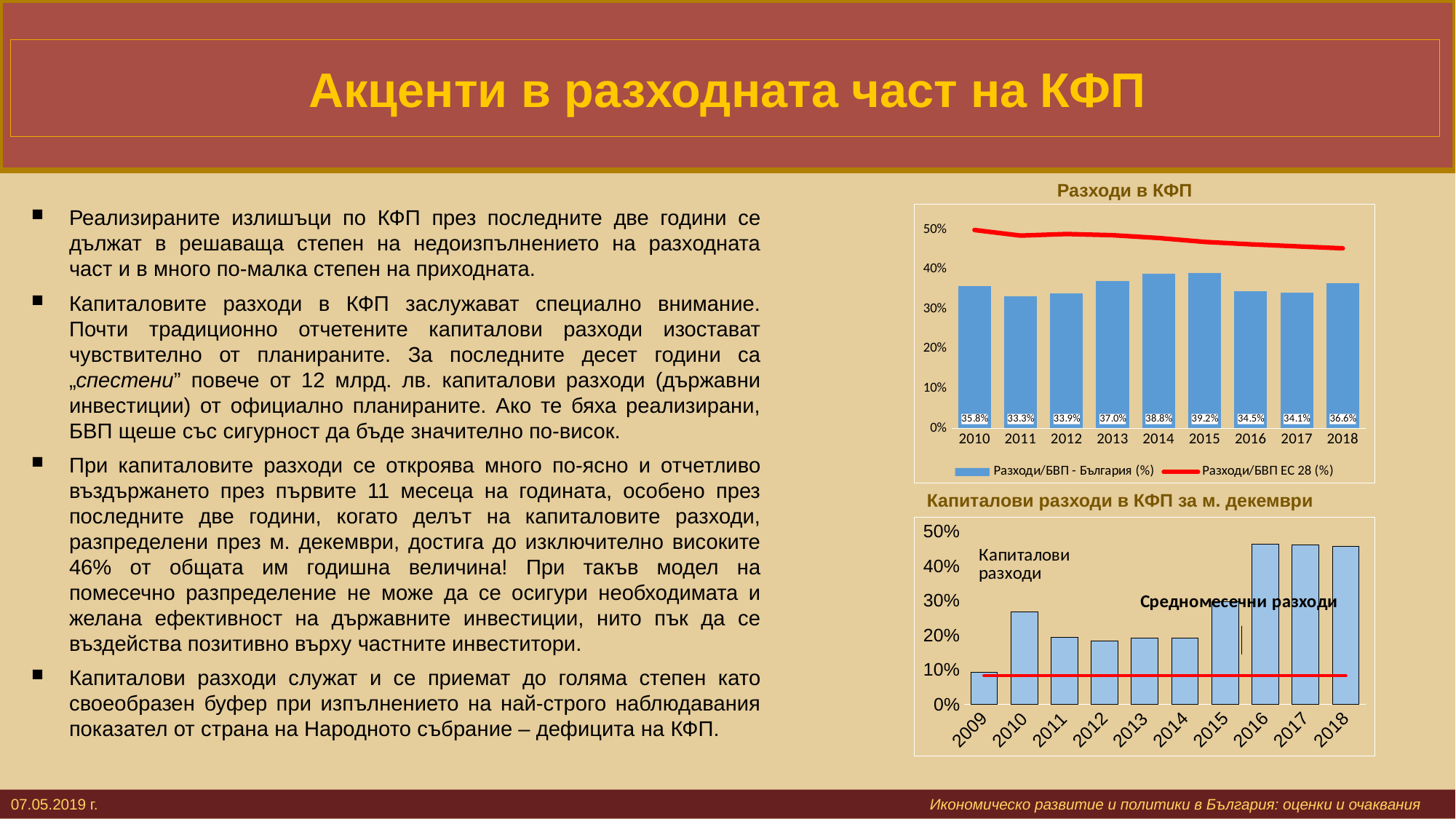
In the chart titled "Капиталови разходи в КФП за м. декември", is the value for 2017 greater or less than 40%? greater In the chart titled "Разходи в КФП", how many series does the legend list? 2 In the chart titled "Разходи в КФП", which year has the highest bar value? 2015 In the chart titled "Разходи в КФП", how many years are shown on the x axis? 9 In the chart titled "Разходи в КФП", which year has the lowest bar value? 2011 In the chart titled "Разходи в КФП", which is larger, the value for 2013 or the value for 2016? 2013 In the chart titled "Разходи в КФП", what is the value for 2018? 36.6% In the chart titled "Разходи в КФП", what is the value for 2014? 38.8% In the chart titled "Разходи в КФП", what is the difference between the values for 2015 and 2011? 5.9% What kind of chart is the chart titled "Капиталови разходи в КФП за м. декември"? combination bar and line chart In the chart titled "Капиталови разходи в КФП за м. декември", is the value for 2009 greater or less than 20%? less In the chart titled "Разходи в КФП", does the red line for Разходи/БВП ЕС 28 (%) rise or fall from 2010 to 2018? fall